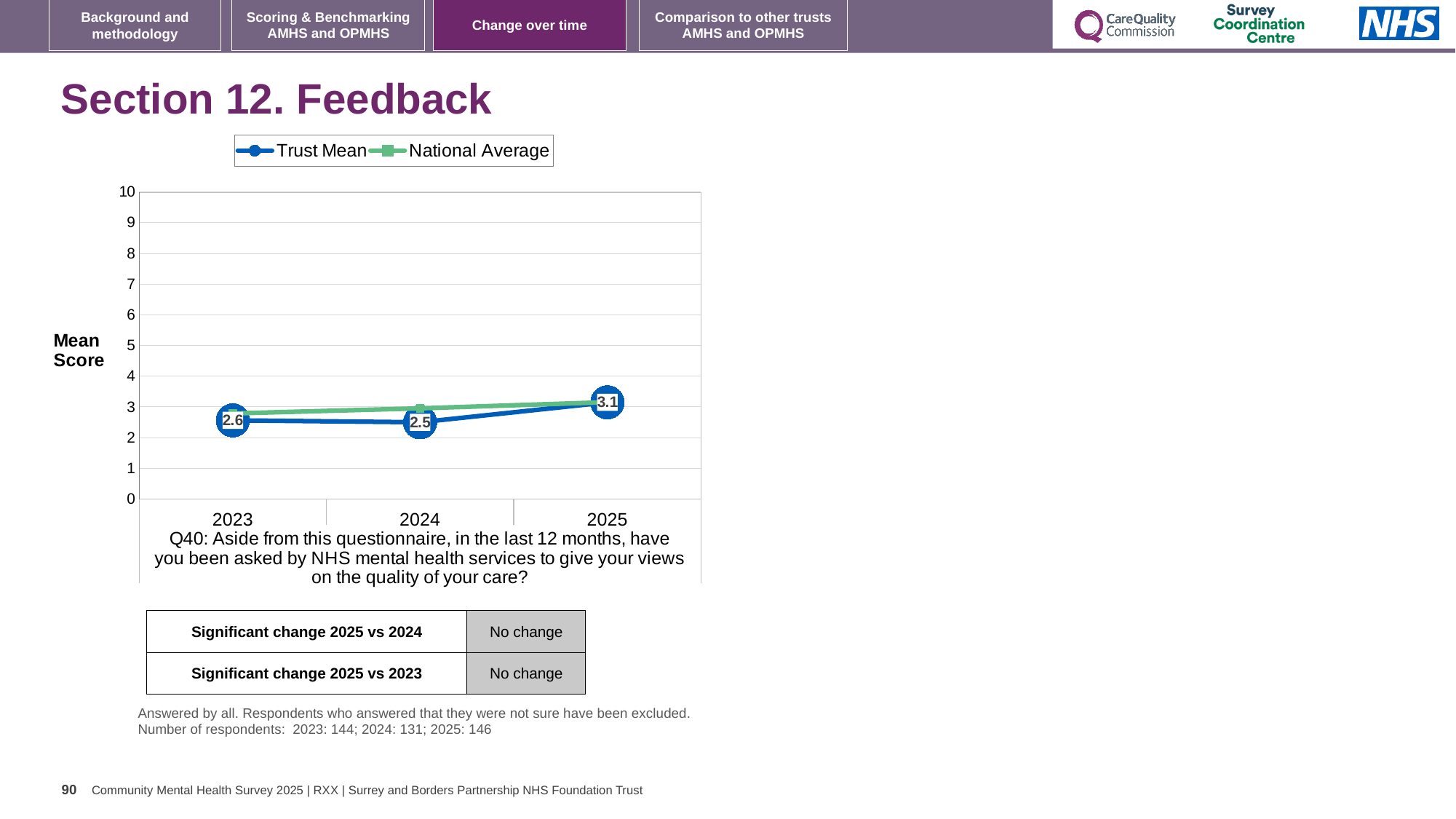
In which year is the Trust Mean score lowest? 2024 Is the National Average value for 2023 greater or less than 5? less In which year is the Trust Mean score highest? 2025 What is the Trust Mean score for 2023? 2.6 What is the difference between the Trust Mean score in 2025 and in 2024? 0.6 What is the Trust Mean score for 2024? 2.5 Which is larger, the Trust Mean score in 2023 or in 2025? 2025 How many years are shown on the x axis of the chart? 3 What is the Trust Mean score for 2025? 3.1 How many series does the chart legend list? 2 What kind of chart is shown on the slide? line chart Does the Trust Mean score rise or fall between 2024 and 2025? rise